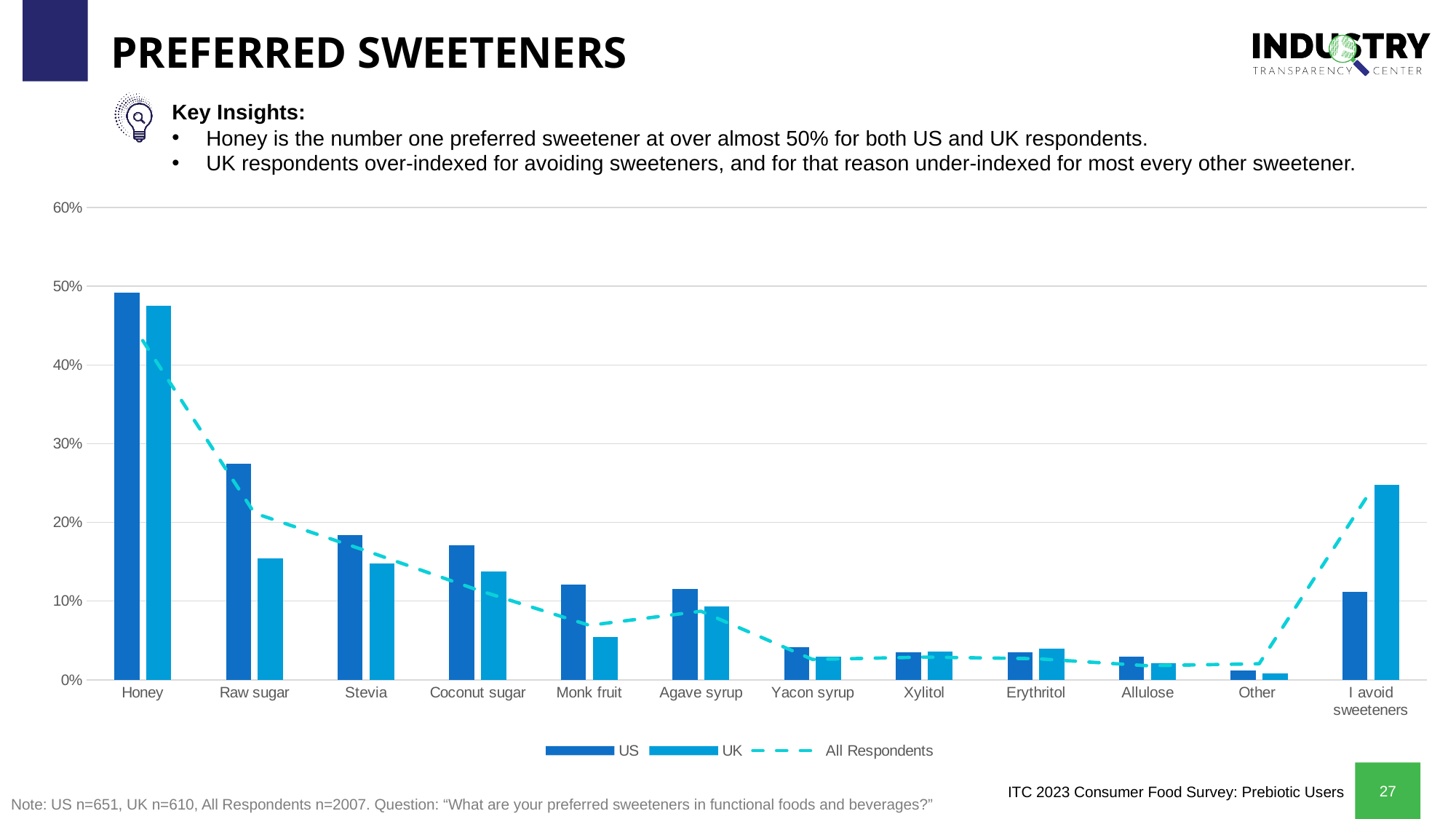
Which category has the highest US value? Honey Which series in the legend is drawn as a dashed line? All Respondents Is the UK value for 'I avoid sweeteners' greater or less than 20%? greater Is the UK value for Raw sugar greater or less than 20%? less What kind of chart is shown on the slide? bar chart with a dashed line Is the US value for Honey greater or less than 40%? greater Which category has the lowest UK value? Other For 'I avoid sweeteners', which is larger: the US value or the UK value? UK For Raw sugar, which is larger: the US value or the UK value? US How many series does the chart legend list? 3 How many sweetener categories are shown on the x axis of the chart? 12